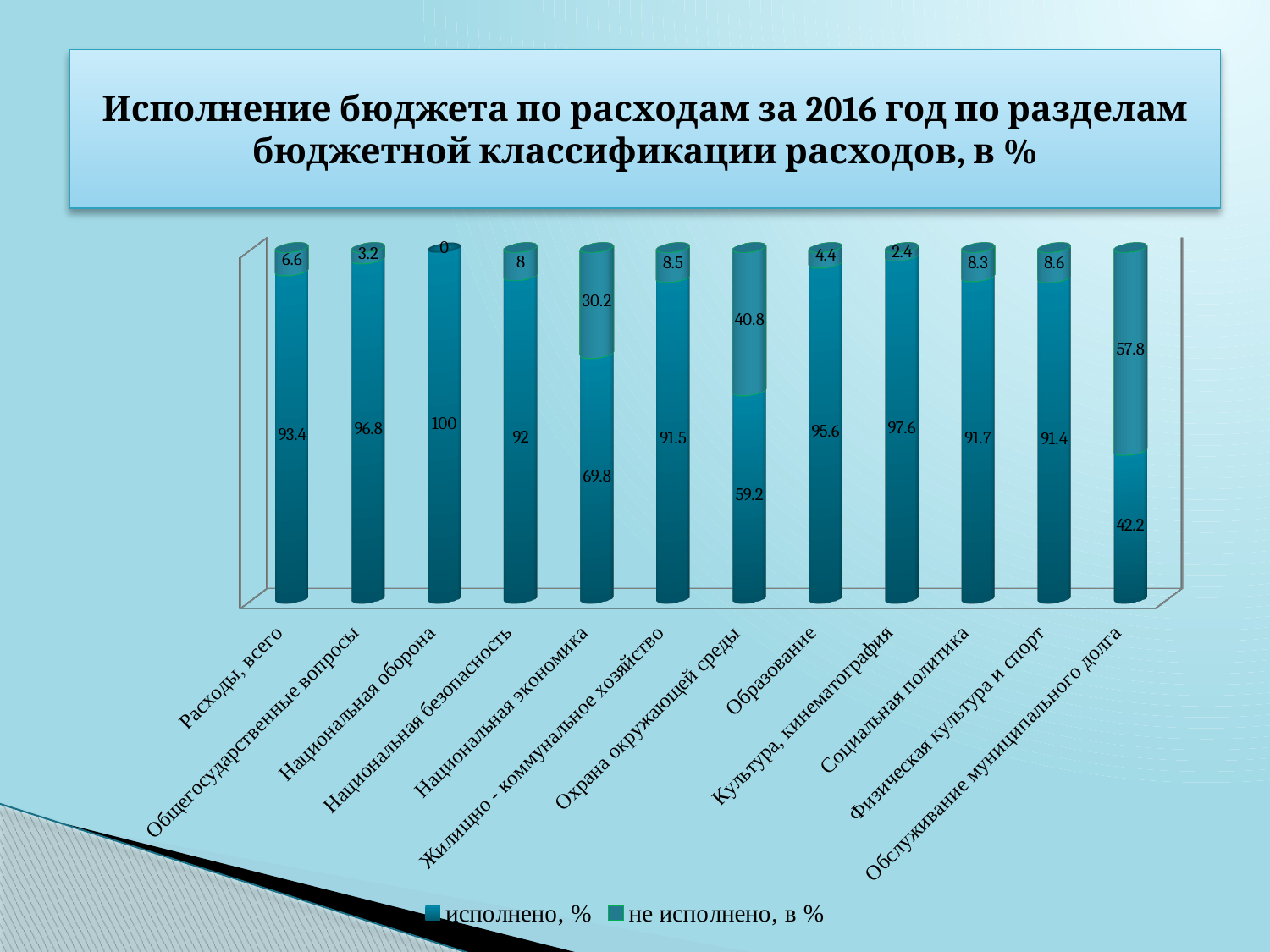
What is the value of "исполнено, %" for "Культура, кинематография"? 97.6 Which category has the highest value of "исполнено, %"? Национальная оборона Which category has the lowest value of "исполнено, %"? Обслуживание муниципального долга What is the total of the stacked bar for "Национальная безопасность"? 100 What is the value of "не исполнено, в %" for "Охрана окружающей среды"? 40.8 Which category has the highest value of "не исполнено, в %"? Обслуживание муниципального долга What type of chart is shown on the slide? Stacked bar chart How many categories are shown on the x axis? 12 What is the value of "исполнено, %" for "Национальная экономика"? 69.8 Which is larger: the "исполнено, %" value for "Общегосударственные вопросы" or for "Социальная политика"? Общегосударственные вопросы What is the difference between the "исполнено, %" values for "Образование" and "Охрана окружающей среды"? 36.4 How many series does the legend list? 2